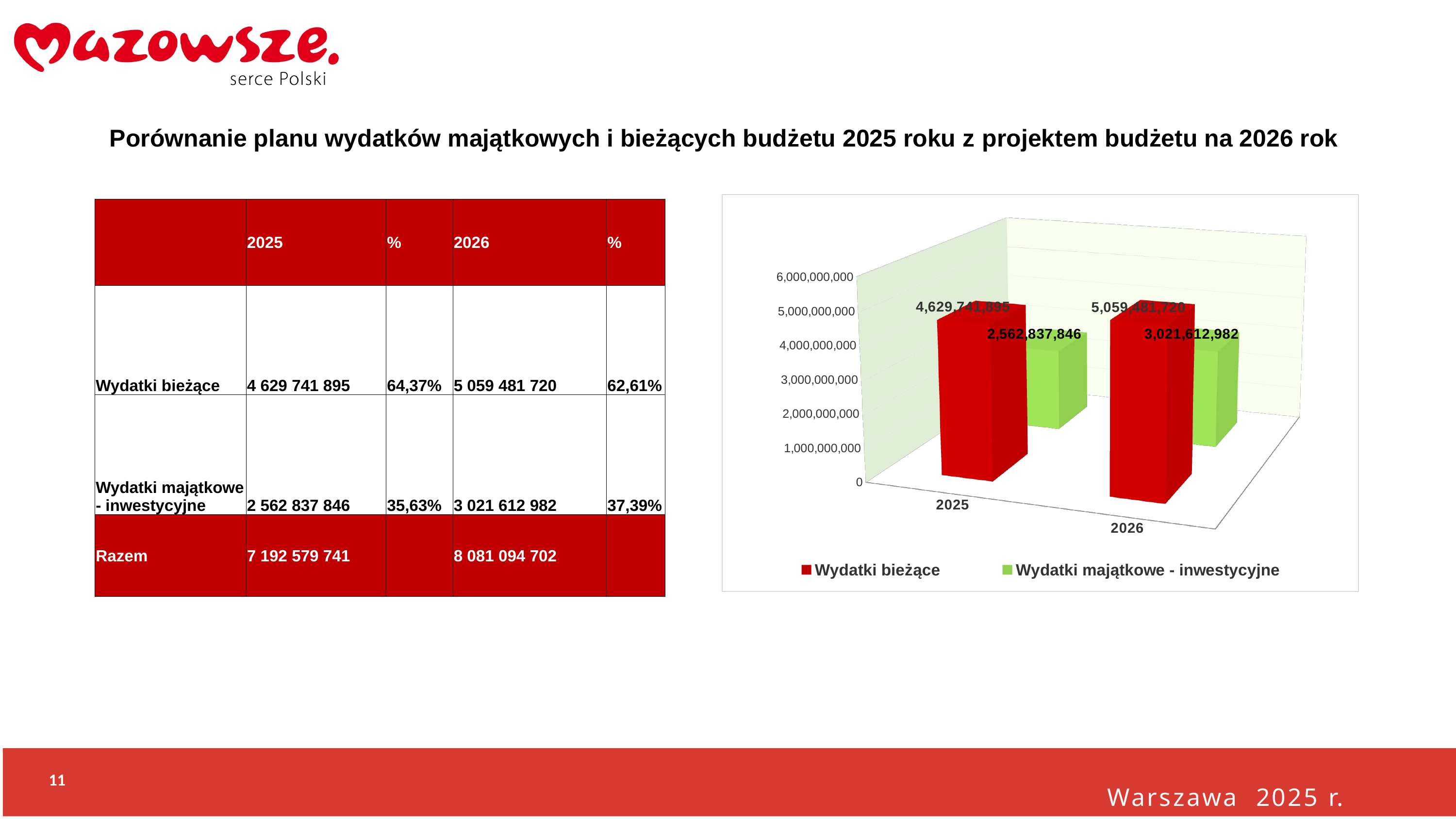
Which year has the higher value for Wydatki bieżące in the chart? 2026 How many series does the chart legend list? 2 What is the value of Wydatki bieżące for 2025 in the chart? 4,629,741,895 What type of chart is shown on the slide? Bar chart In 2026, which is larger in the chart: Wydatki bieżące or Wydatki majątkowe - inwestycyjne? Wydatki bieżące Which bar in the chart has the lowest value? Wydatki majątkowe - inwestycyjne in 2025 Is the value for Wydatki majątkowe - inwestycyjne in 2025 greater or less than 3,000,000,000? less What is the difference between Wydatki bieżące and Wydatki majątkowe - inwestycyjne in 2025 in the chart? 2,066,904,049 What is the value of Wydatki majątkowe - inwestycyjne for 2026 in the chart? 3,021,612,982 By how much does Wydatki bieżące increase from 2025 to 2026 in the chart? 429,739,825 What is the value of Wydatki bieżące for 2026 in the chart? 5,059,481,720 What is the value of Wydatki majątkowe - inwestycyjne for 2025 in the chart? 2,562,837,846